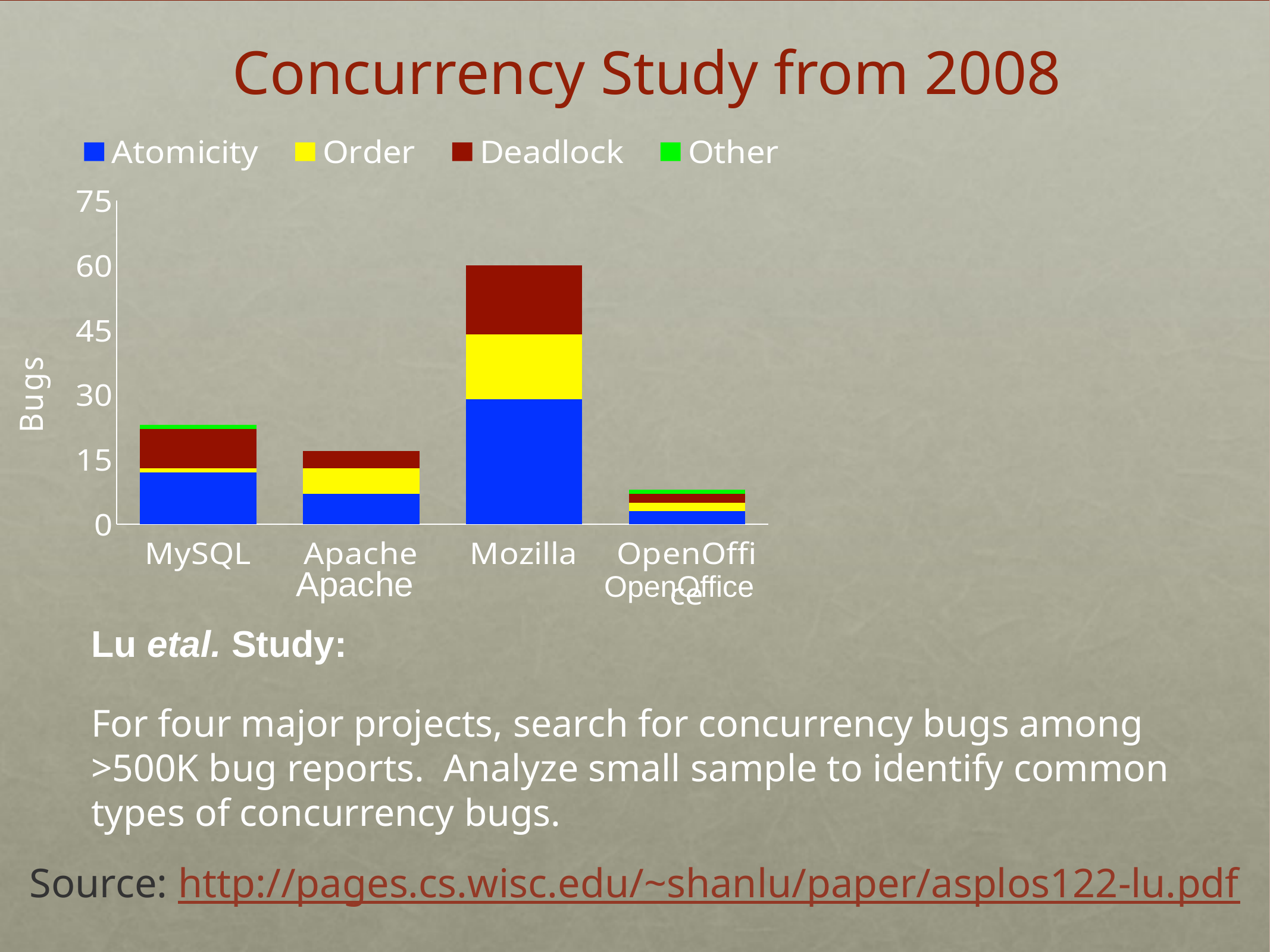
How many projects (categories) are shown on the x axis of the chart? 4 Which has a larger total bar, MySQL or Apache? MySQL Is the total bar for Mozilla greater or less than 45? greater What is the label on the y axis of the chart? Bugs Which bug type makes up the largest segment of the Mozilla bar? Atomicity How many series does the chart's legend list? 4 Which project has the lowest total number of bugs in the chart? OpenOffice Which colour represents the Deadlock series in the chart's legend? dark red Is the total bar for OpenOffice greater or less than 15? less Is the total bar for MySQL greater or less than 30? less Which project has the highest total number of bugs in the chart? Mozilla What kind of chart is shown on the slide? bar chart